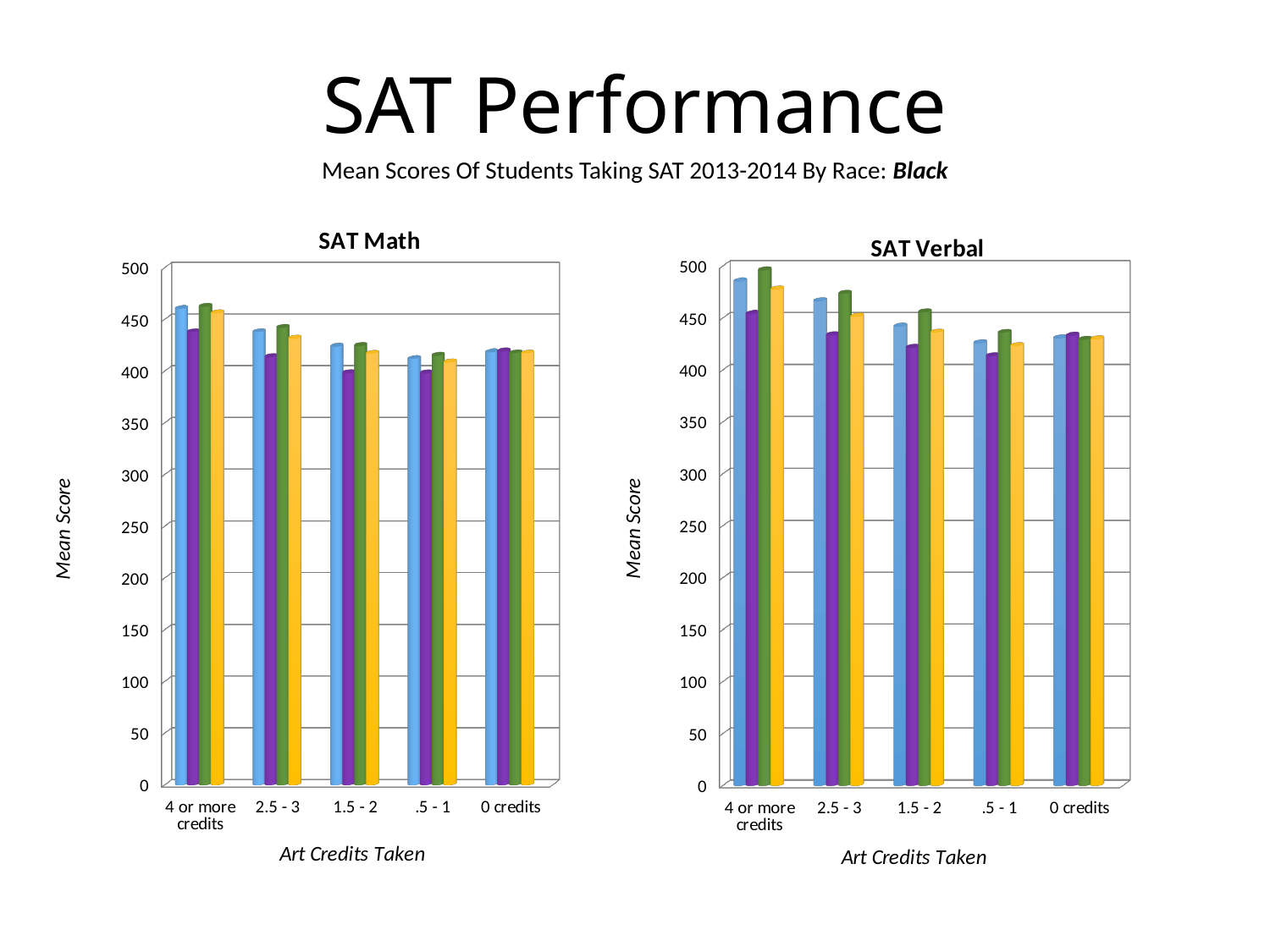
How many art-credit categories are shown on the x axis of the SAT Verbal chart? 5 What kind of chart is the SAT Math chart? bar chart In the SAT Verbal chart, which art-credit category contains the highest bar? 4 or more credits What is the label of the x axis on the SAT Math chart? Art Credits Taken In the SAT Math chart, which is larger: the blue bar for '4 or more credits' or the blue bar for '0 credits'? 4 or more credits In the SAT Verbal chart, do the scores generally rise or fall moving from '4 or more credits' to '0 credits' along the x axis? fall What is the label of the y axis on the SAT Verbal chart? Mean Score In the SAT Verbal chart, is the value of the green bar for '4 or more credits' greater or less than 450? greater In the SAT Math chart, is the value of the blue bar for '4 or more credits' greater or less than 450? greater In the SAT Verbal chart, is the value of the purple bar for '.5 - 1' credits greater or less than 450? less In the SAT Math chart, which art-credit category has the tallest bars? 4 or more credits